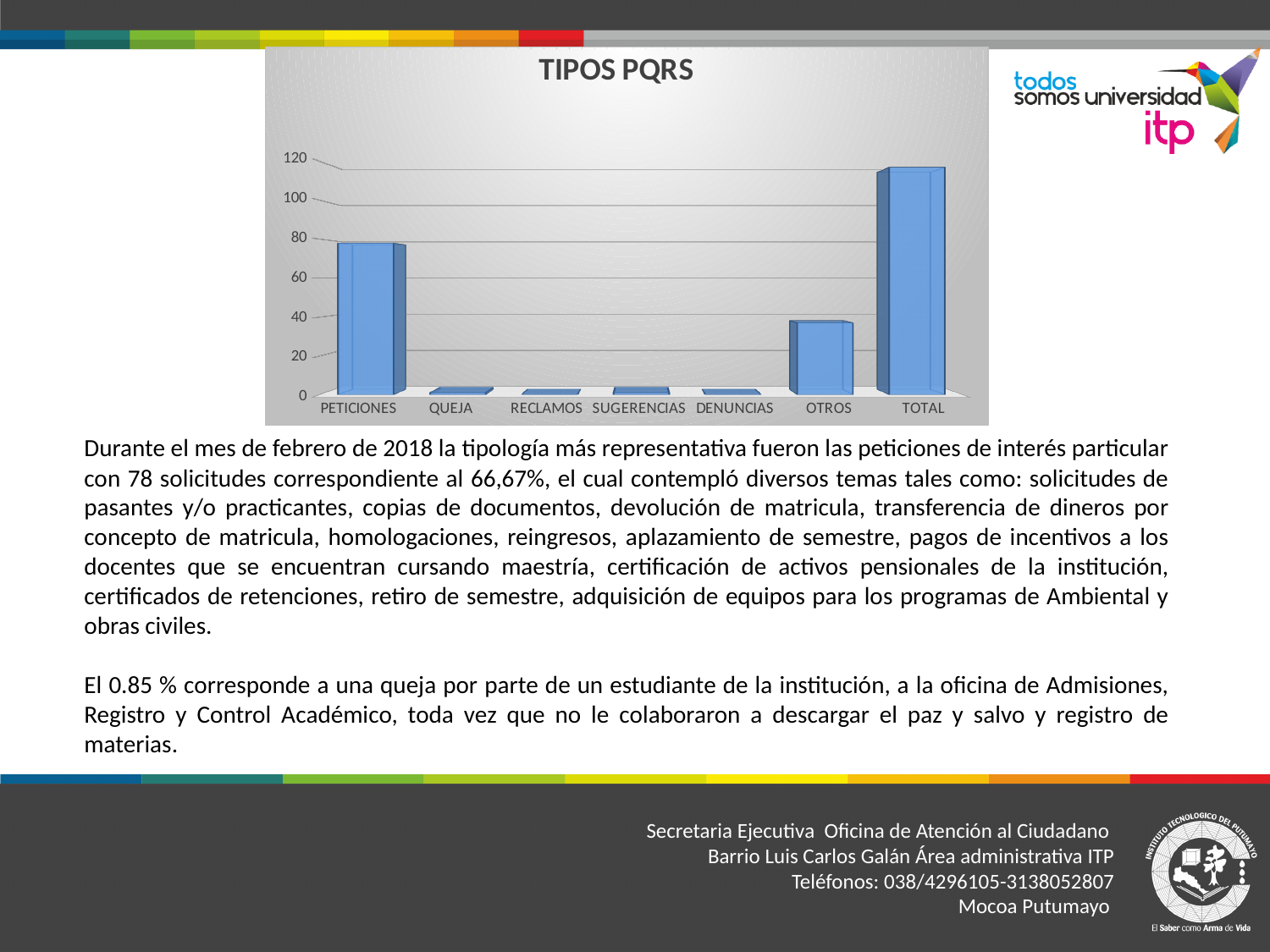
Which category has the highest bar in the chart? TOTAL Which is larger, the value for OTROS or the value for QUEJA? OTROS Is the value for TOTAL greater or less than 100? greater Is the value for DENUNCIAS greater or less than 20? less What is the title of the chart? TIPOS PQRS Is the value for PETICIONES greater or less than 60? greater Which is larger, the value for PETICIONES or the value for OTROS? PETICIONES How many categories are shown on the x axis of the chart? 7 What kind of chart is shown on the slide? bar chart What is the highest value shown on the vertical axis of the chart? 120